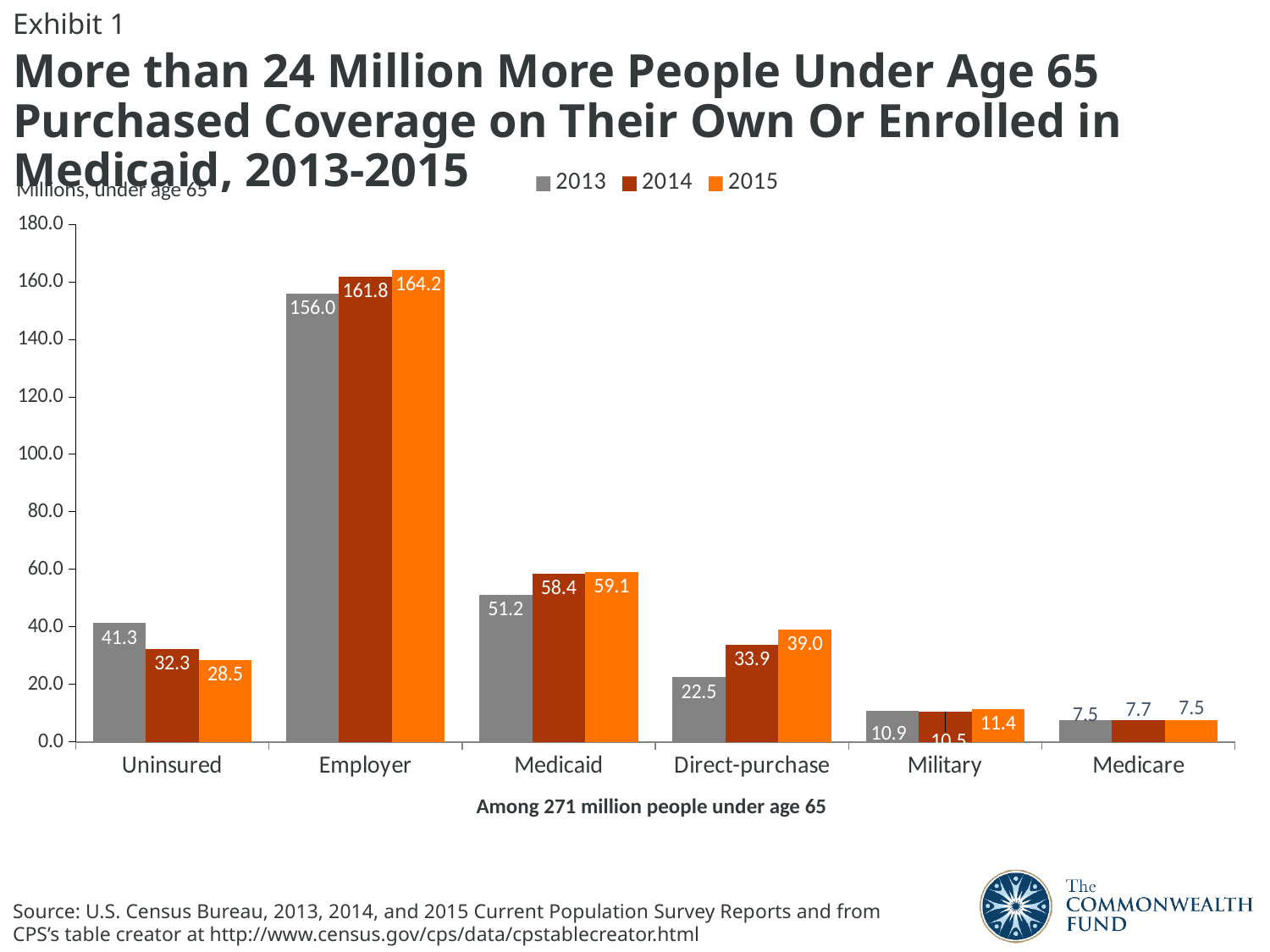
By how much did the number of uninsured people fall from 2013 to 2015? 12.8 What was the value for Employer coverage in 2015? 164.2 Which is larger: the Direct-purchase value in 2015 or the Uninsured value in 2015? Direct-purchase in 2015 Did the Direct-purchase values rise or fall from 2013 to 2015? Rise What was the number of uninsured people under age 65 in 2013? 41.3 What kind of chart is shown on the slide? Bar chart Which coverage category had the highest value in 2015? Employer What is the difference between the Medicaid values for 2015 and 2013? 7.9 Which coverage category had the lowest value in 2013? Medicare How many coverage categories are shown on the x axis? 6 What was the value for Direct-purchase coverage in 2014? 33.9 How many series does the legend list? 3